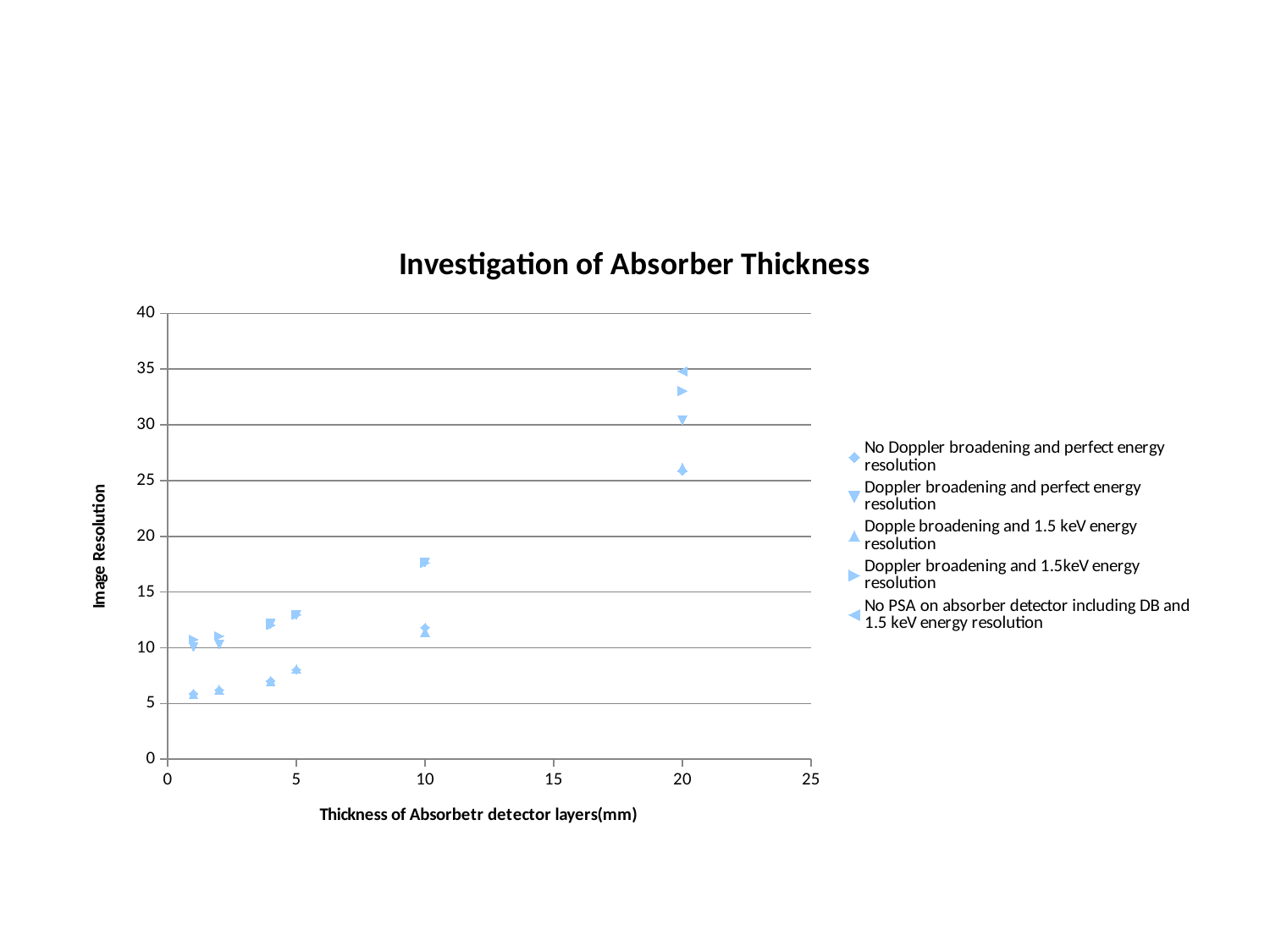
What is the label of the vertical axis? Image Resolution Is the value for the 'No Doppler broadening and perfect energy resolution' series at 20 mm greater or less than 20? greater How many series does the legend list? 5 Is the highest plotted value at 10 mm greater or less than 15? greater Do the image resolution values rise or fall as the absorber thickness increases? Rise At which absorber thickness are the highest image resolution values plotted? 20 What is the title of the chart? Investigation of Absorber Thickness What kind of chart is shown on the slide? Scatter chart Is the value for the 'No Doppler broadening and perfect energy resolution' series at 20 mm greater or less than 30? less Which is larger: the highest plotted value at 20 mm or the highest plotted value at 10 mm? 20 mm How many distinct absorber thickness values have points plotted? 6